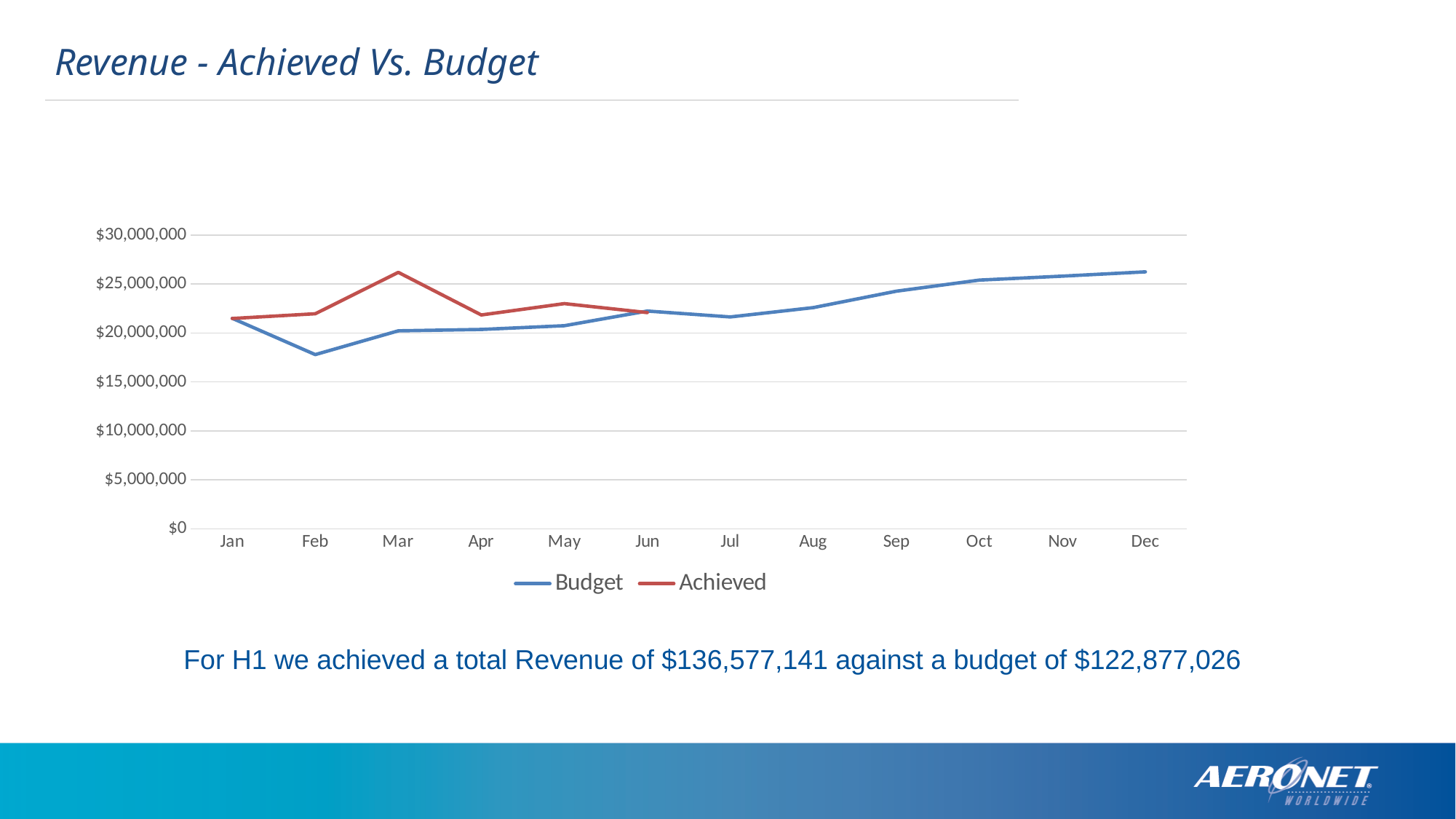
In which month is the Achieved revenue highest? Mar How many series does the legend list? 2 In which month is the Budget revenue lowest? Feb In Mar, which is larger: Budget or Achieved? Achieved What colour is the Achieved line? Red Is the Budget value for Dec greater or less than $25,000,000? greater Does the Budget line rise or fall from Jul to Dec? Rise How many months are shown on the x axis? 12 What kind of chart is shown on the slide? Line chart Is the Achieved value for Mar greater or less than $25,000,000? greater Is the Budget value for Feb greater or less than $20,000,000? less For how many months is the Achieved series plotted? 6